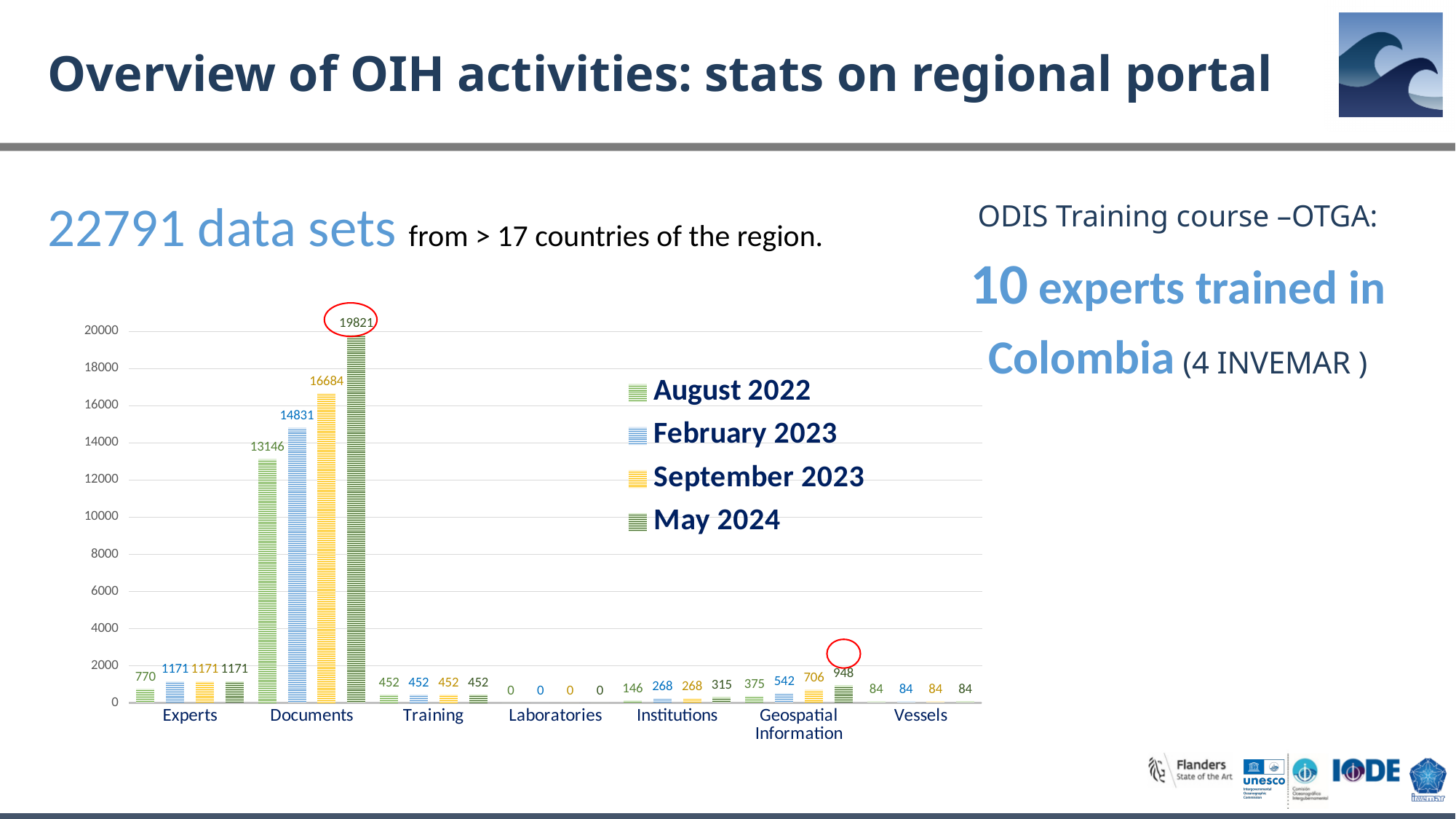
Which is larger, the Geospatial Information value for May 2024 or the Experts value for May 2024? Experts value for May 2024 What is the value for Documents in May 2024? 19821 What is the value for Experts in August 2022? 770 What kind of chart is shown on the slide? Bar chart What is the value for Geospatial Information in September 2023? 706 How many series does the legend list? 4 Which category has the highest value in May 2024? Documents How many categories are shown on the x axis? 7 Which category has the lowest value in August 2022? Laboratories Do the Documents values rise or fall from August 2022 to May 2024? Rise What is the value for Institutions in May 2024? 315 What is the difference between the Documents values for May 2024 and August 2022? 6675